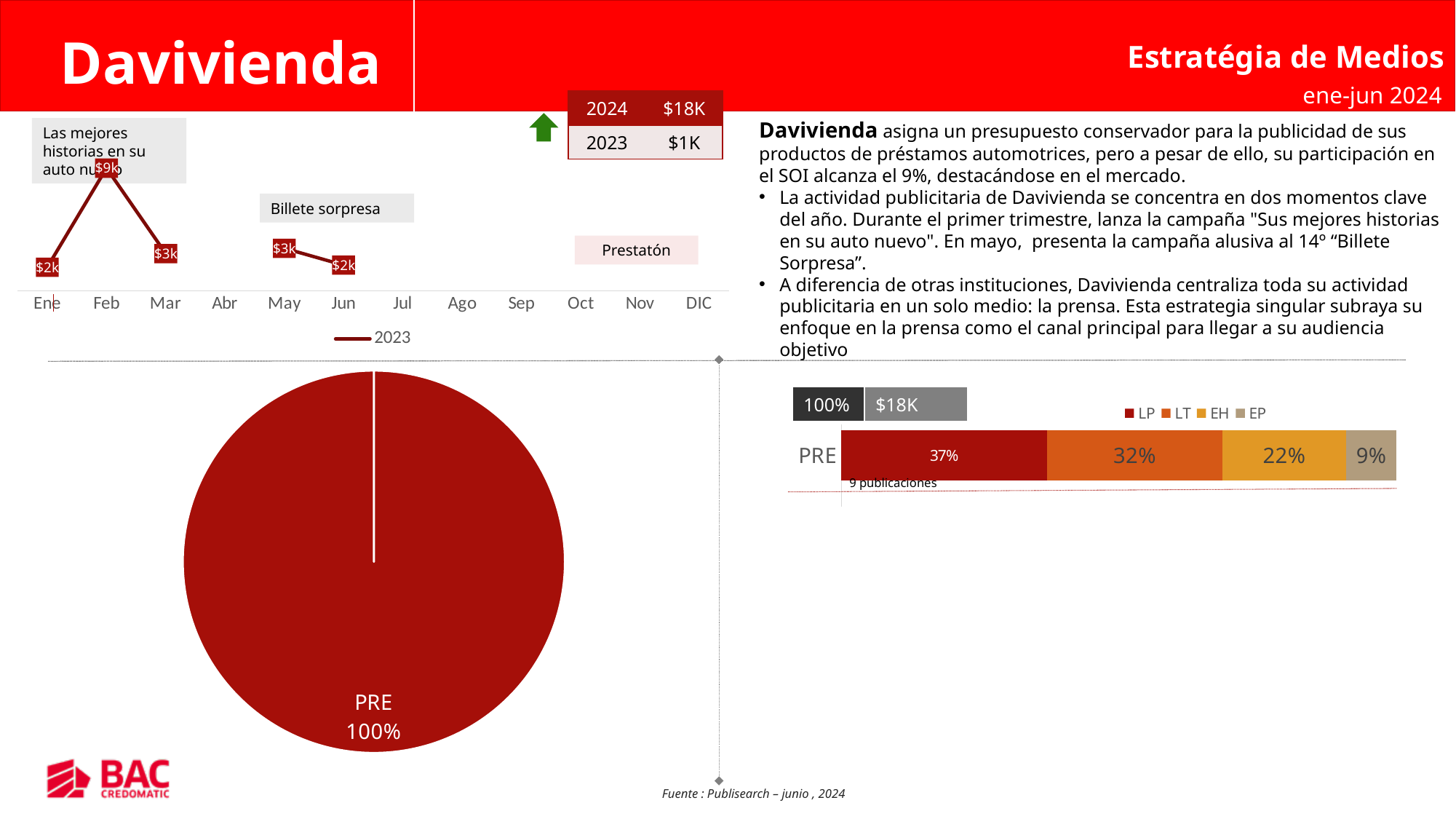
In the stacked bar chart at the bottom right, what is the difference between the LT value and the EP value? 23% In the line chart at the top left, which is larger, the value for Mar or the value for Jun? Mar In the line chart at the top left, which month has the highest value? Feb In the line chart at the top left, what is the value for Jun? $2k In the line chart at the top left, what is the difference between the Feb value and the Mar value? $6k In the stacked bar chart at the bottom right, what is the value for LP in the PRE bar? 37% In the pie chart at the bottom left, what share does the PRE slice have? 100% In the stacked bar chart at the bottom right, how many series does the legend list? 4 What kind of chart is shown at the bottom left of the slide? Pie chart In the line chart at the top left, what is the value for Feb? $9k In the line chart at the top left, how many months are labelled on the x axis? 12 In the line chart at the top left, what series name does the legend show? 2023